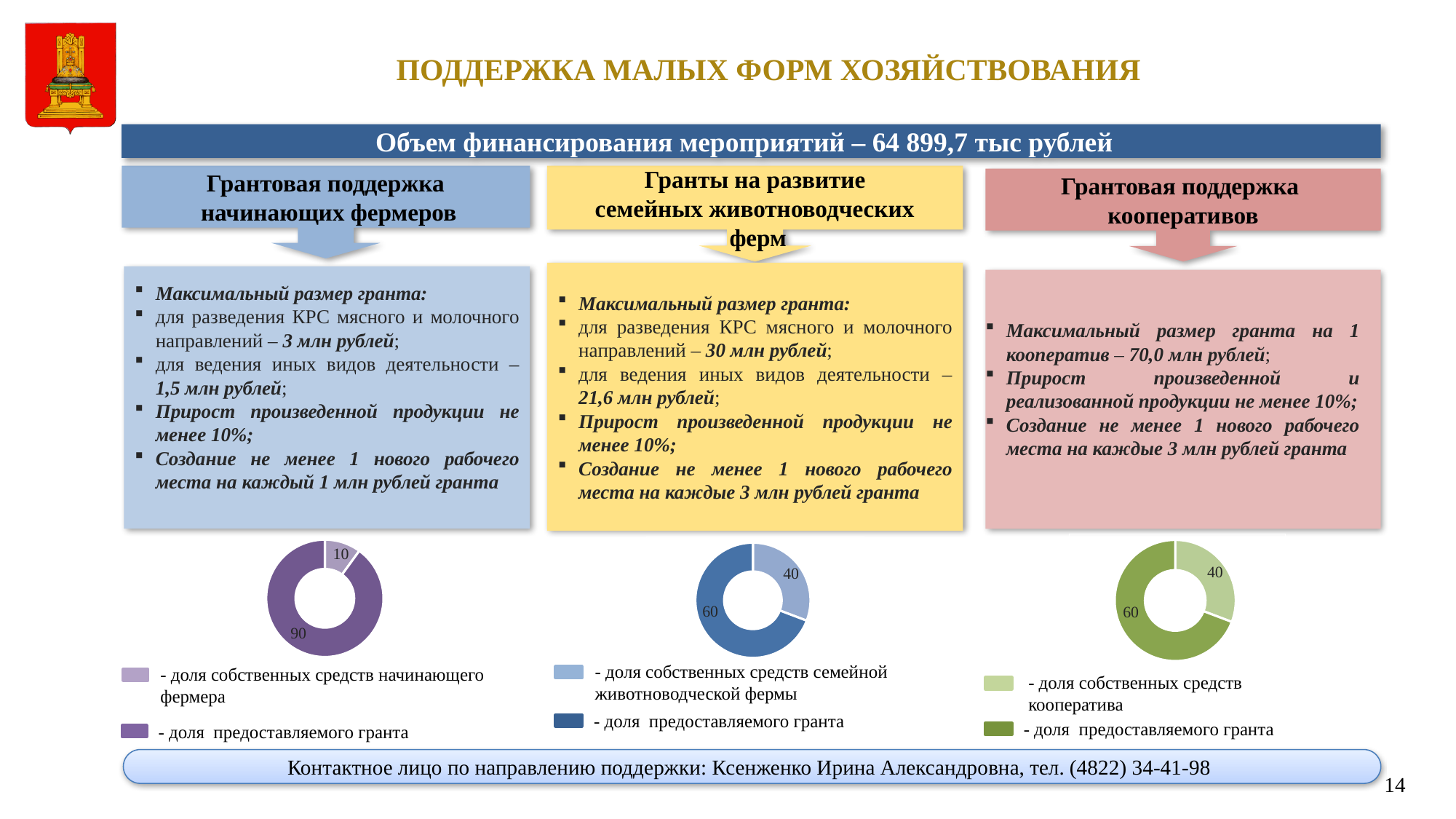
In the middle donut chart (family livestock farms), what is the value for 'доля предоставляемого гранта'? 60 In the middle donut chart (family livestock farms), which is larger: the grant share or the own-funds share? доля предоставляемого гранта In the middle donut chart (family livestock farms), what is the value for 'доля собственных средств семейной животноводческой фермы'? 40 In the left donut chart (beginning farmers), which slice is the largest? доля предоставляемого гранта In the right donut chart (cooperatives), what is the value for 'доля предоставляемого гранта'? 60 In the left donut chart (beginning farmers), what is the value for 'доля предоставляемого гранта'? 90 In the right donut chart (cooperatives), which slice is the smallest? доля собственных средств кооператива How many donut charts are shown on the slide? 3 How many slices does the right donut chart (cooperatives) have? 2 In the left donut chart (beginning farmers), what is the difference between the grant share and the own-funds share? 80 What type of chart is shown under the 'Грантовая поддержка начинающих фермеров' section on the left? Donut (pie) chart In the left donut chart (beginning farmers), what is the value for 'доля собственных средств начинающего фермера'? 10